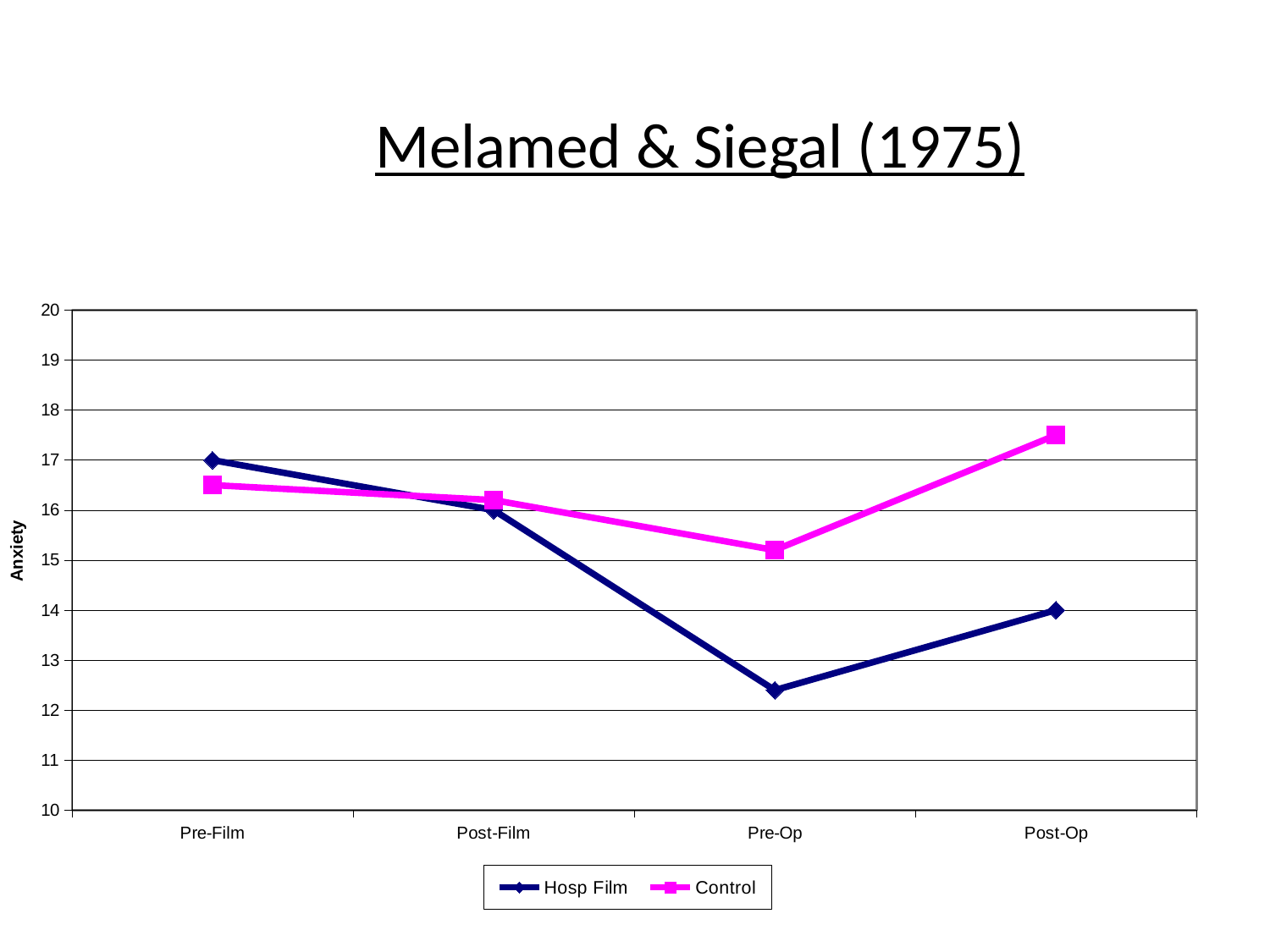
At which time point is the Hosp Film Anxiety value lowest? Pre-Op At Pre-Op, which series has the higher Anxiety value, Hosp Film or Control? Control Is the Anxiety value for Control at Pre-Op greater or less than 15? greater What is the Anxiety value for Hosp Film at Pre-Film? 17 What is the Anxiety value for Hosp Film at Post-Op? 14 How many series does the legend list? 2 How many time points are plotted along the x axis? 4 What type of chart is shown on the slide? line chart At which time point is the Control Anxiety value highest? Post-Op Is the Anxiety value for Hosp Film at Pre-Op greater or less than 13? less Is the Anxiety value for Control at Post-Op greater or less than 17? greater What is the Anxiety value for Hosp Film at Post-Film? 16